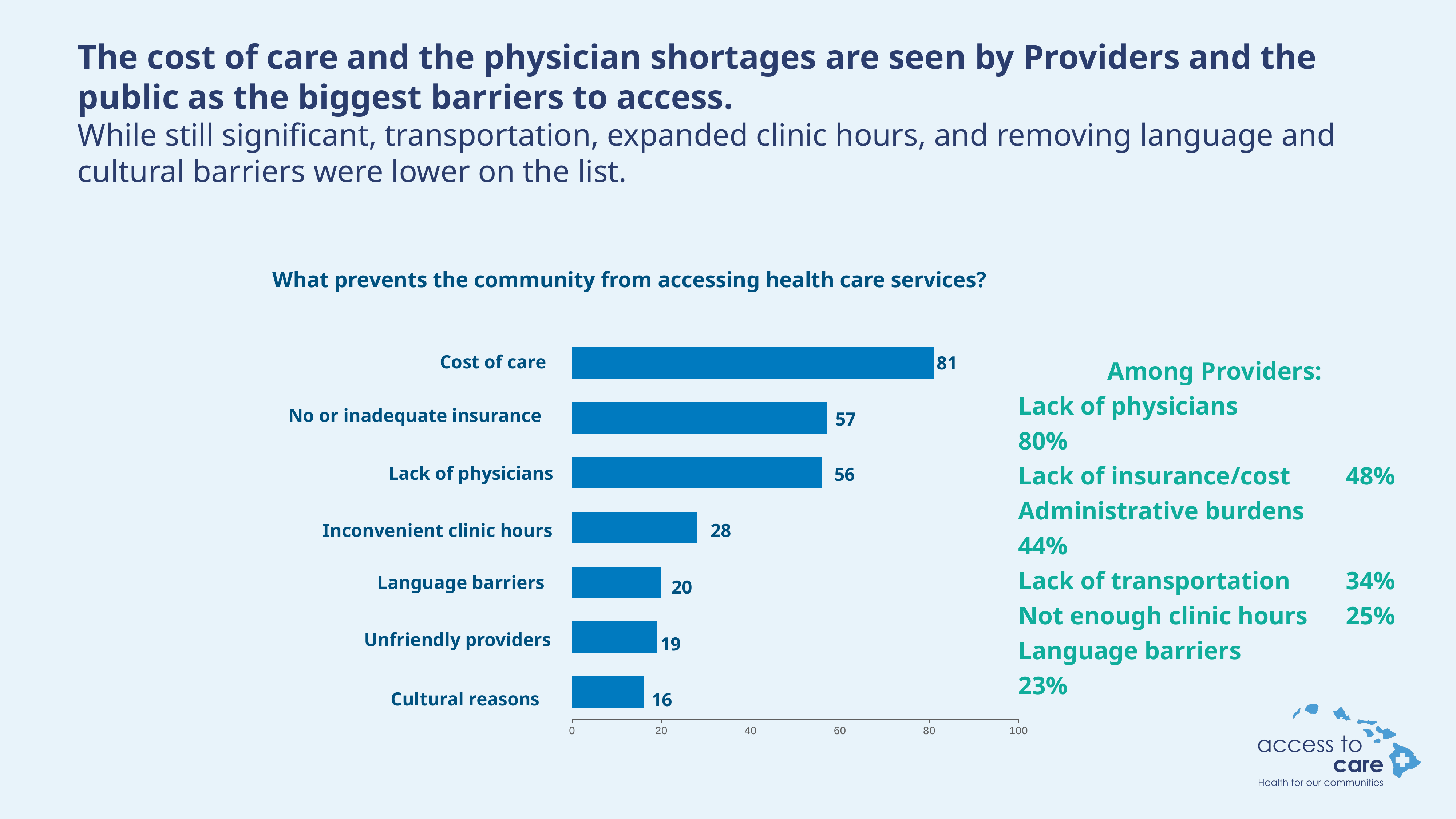
What is the difference between the values for Inconvenient clinic hours and Language barriers? 8 What is the title of the chart? What prevents the community from accessing health care services? What is the difference between the values for Cost of care and No or inadequate insurance? 24 What is the value for Inconvenient clinic hours? 28 How many categories are shown in the chart? 7 Which category has the highest value? Cost of care What is the value for Cultural reasons? 16 Is the value for Cost of care greater or less than 80? greater Which category has the lowest value? Cultural reasons What is the value for Cost of care? 81 Which is larger, the value for Lack of physicians or the value for Inconvenient clinic hours? Lack of physicians What kind of chart is shown on the slide? Bar chart